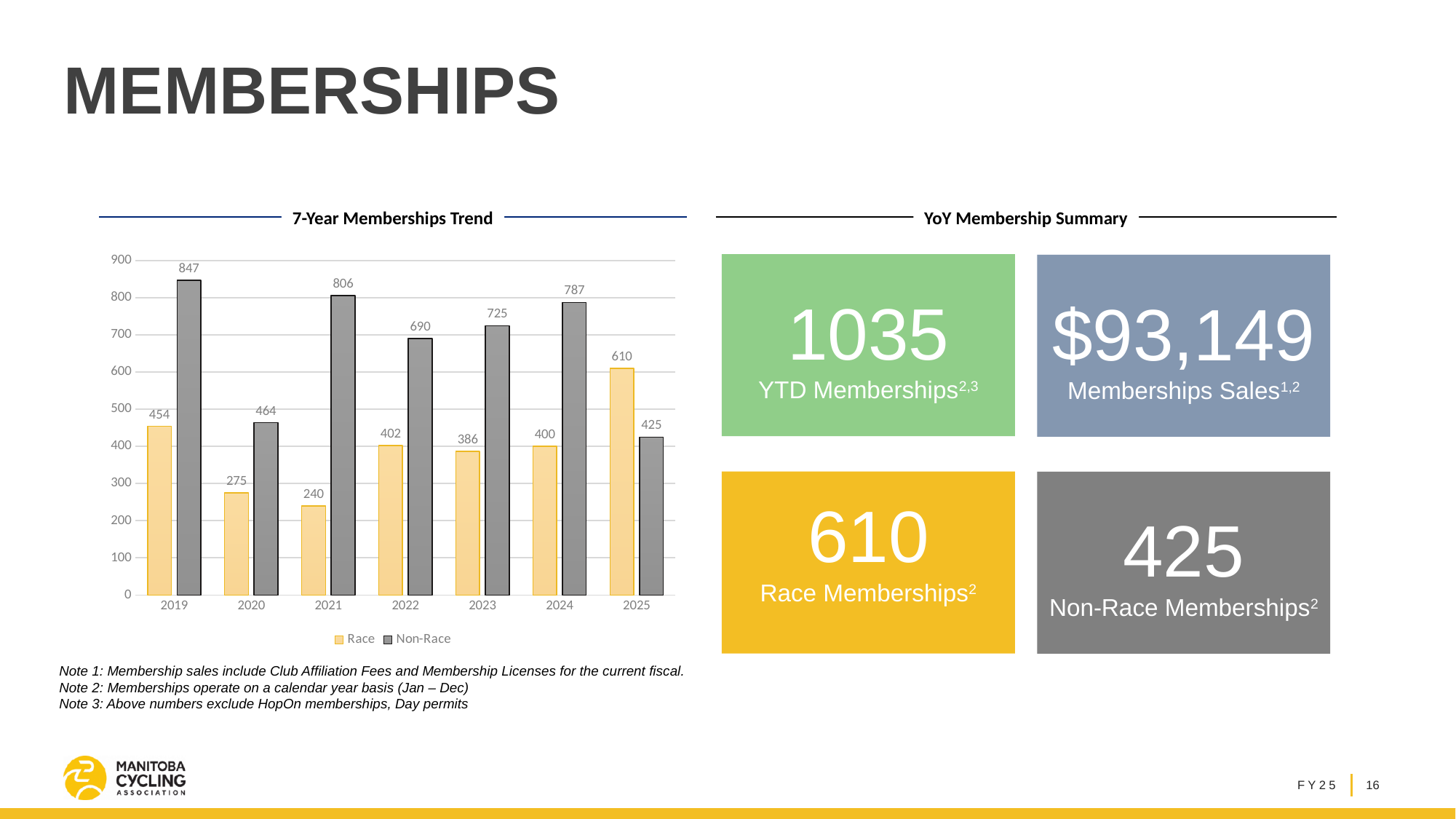
Is the Non-Race membership value for 2022 in the 7-Year Memberships Trend chart greater or less than 600? greater What kind of chart is the 7-Year Memberships Trend chart? Bar chart What is the total of Race and Non-Race memberships for 2025 in the 7-Year Memberships Trend chart? 1035 Which colour represents the Race series in the 7-Year Memberships Trend chart? Yellow What is the difference between the Non-Race and Race membership values for 2024 in the 7-Year Memberships Trend chart? 387 Which year has the highest Non-Race membership value in the 7-Year Memberships Trend chart? 2019 Which year has the lowest Race membership value in the 7-Year Memberships Trend chart? 2021 What is the Race membership value for 2021 in the 7-Year Memberships Trend chart? 240 What is the Non-Race membership value for 2019 in the 7-Year Memberships Trend chart? 847 How many years are shown on the x axis of the 7-Year Memberships Trend chart? 7 How many series does the legend of the 7-Year Memberships Trend chart list? 2 In the 7-Year Memberships Trend chart, which is larger for 2025: Race or Non-Race memberships? Race